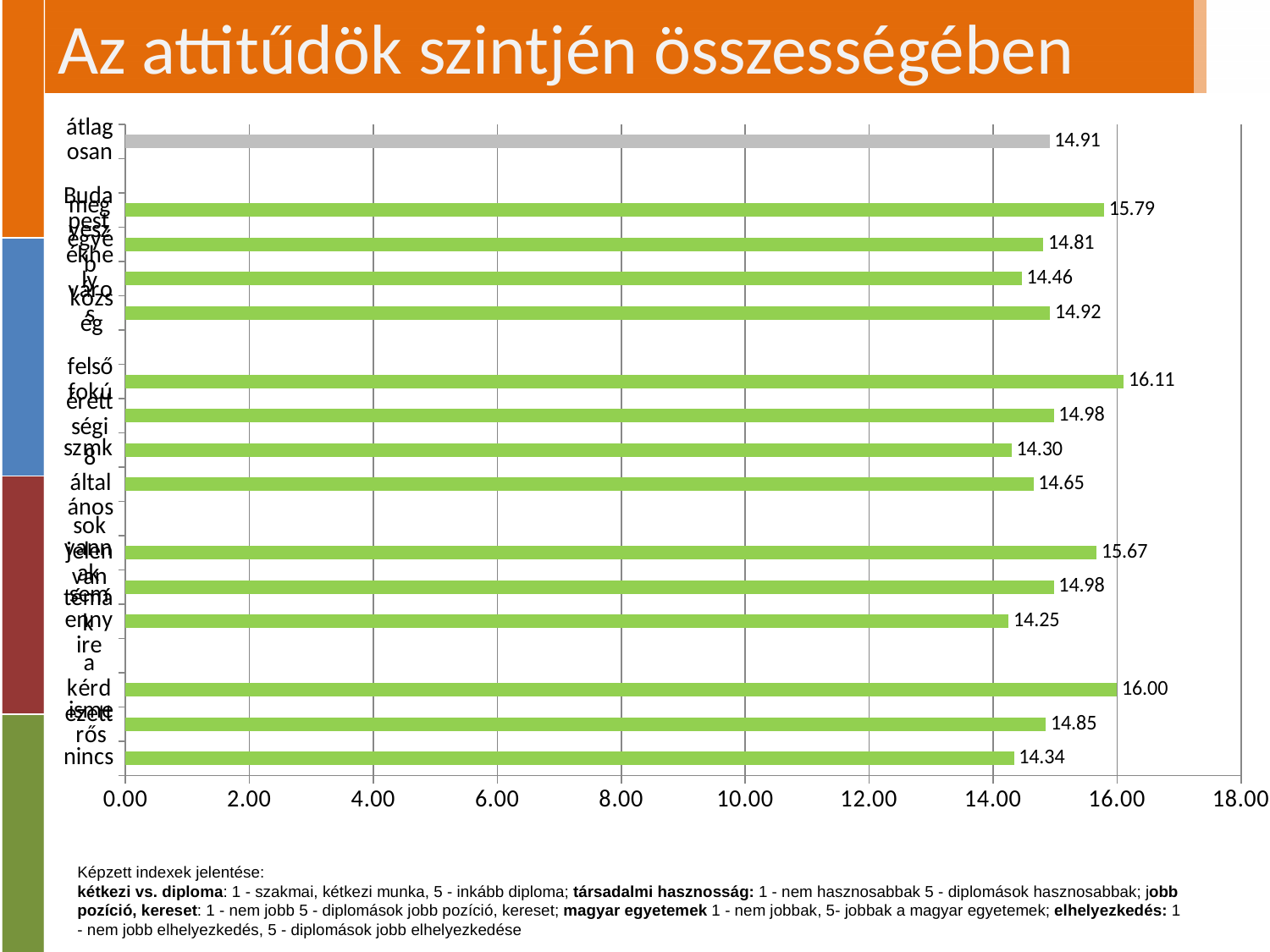
Which is larger, the value for 'Budapest' or for 'község'? Budapest How many bars are plotted in the chart? 15 What is the value for 'nincs'? 14.34 What is the value for 'szmk'? 14.30 What is the difference between the values for 'felsőfokú' and 'szmk'? 1.81 Which category has the highest value in the chart? felsőfokú What kind of chart is shown on the slide? bar chart What is the title of the slide containing the chart? Az attitűdök szintjén összességében What is the value for 'felsőfokú'? 16.11 What is the value for 'általános'? 14.65 What is the value for 'átlagosan'? 14.91 What is the value for 'Budapest'? 15.79